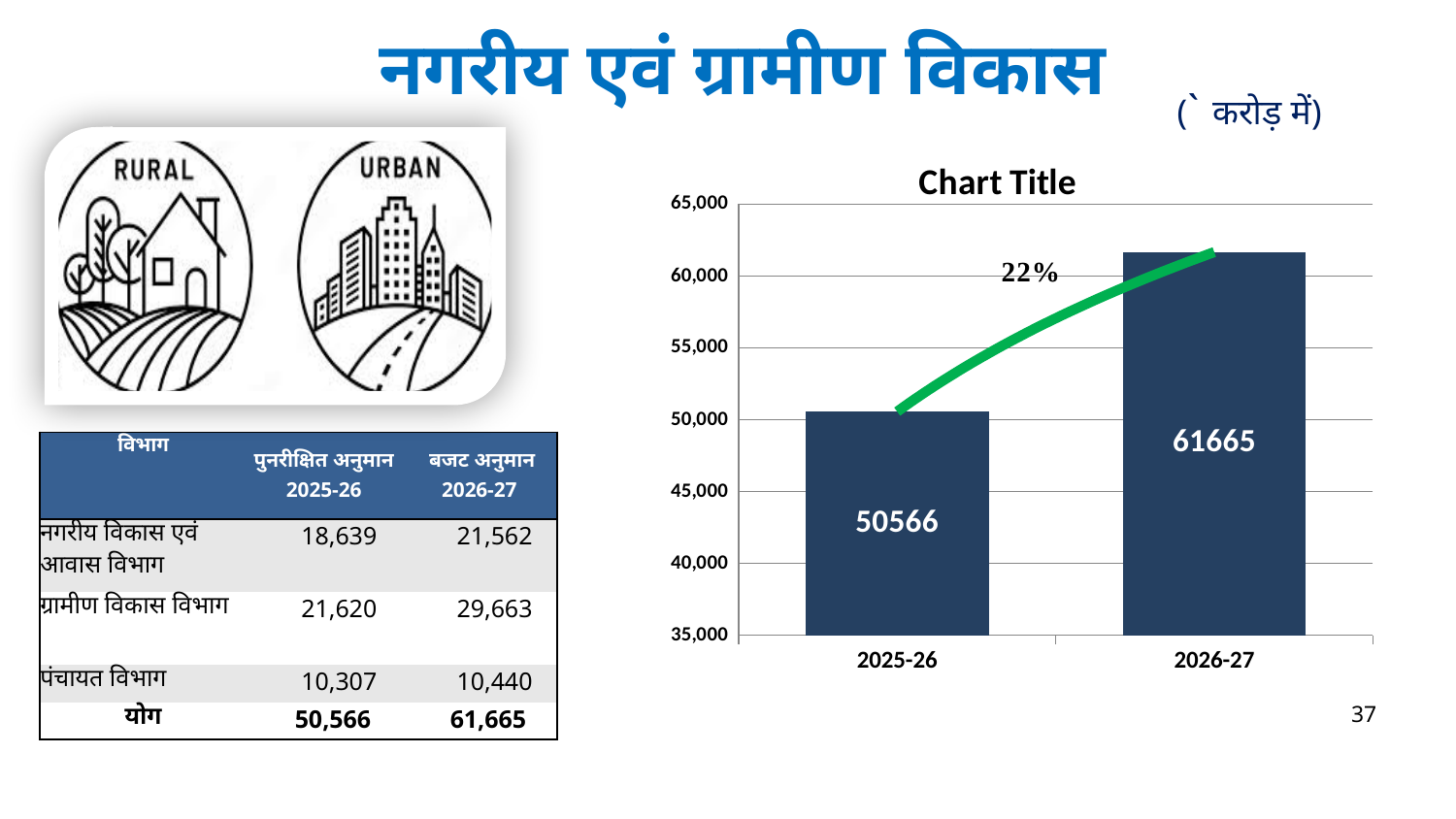
Which category has the highest value? 2026-27 Do the values rise or fall from 2025-26 to 2026-27? rise Is the value for 2025-26 greater or less than 55,000? less What kind of chart is shown? bar chart Which category has the lowest value? 2025-26 Is the value for 2026-27 greater or less than 60,000? greater What percentage is written next to the green arrow on the chart? 22% What is the value for 2026-27? 61665 How many categories are shown on the x axis? 2 Which is larger, the value for 2025-26 or the value for 2026-27? 2026-27 What is the value for 2025-26? 50566 What is the difference between the values for 2026-27 and 2025-26? 11099